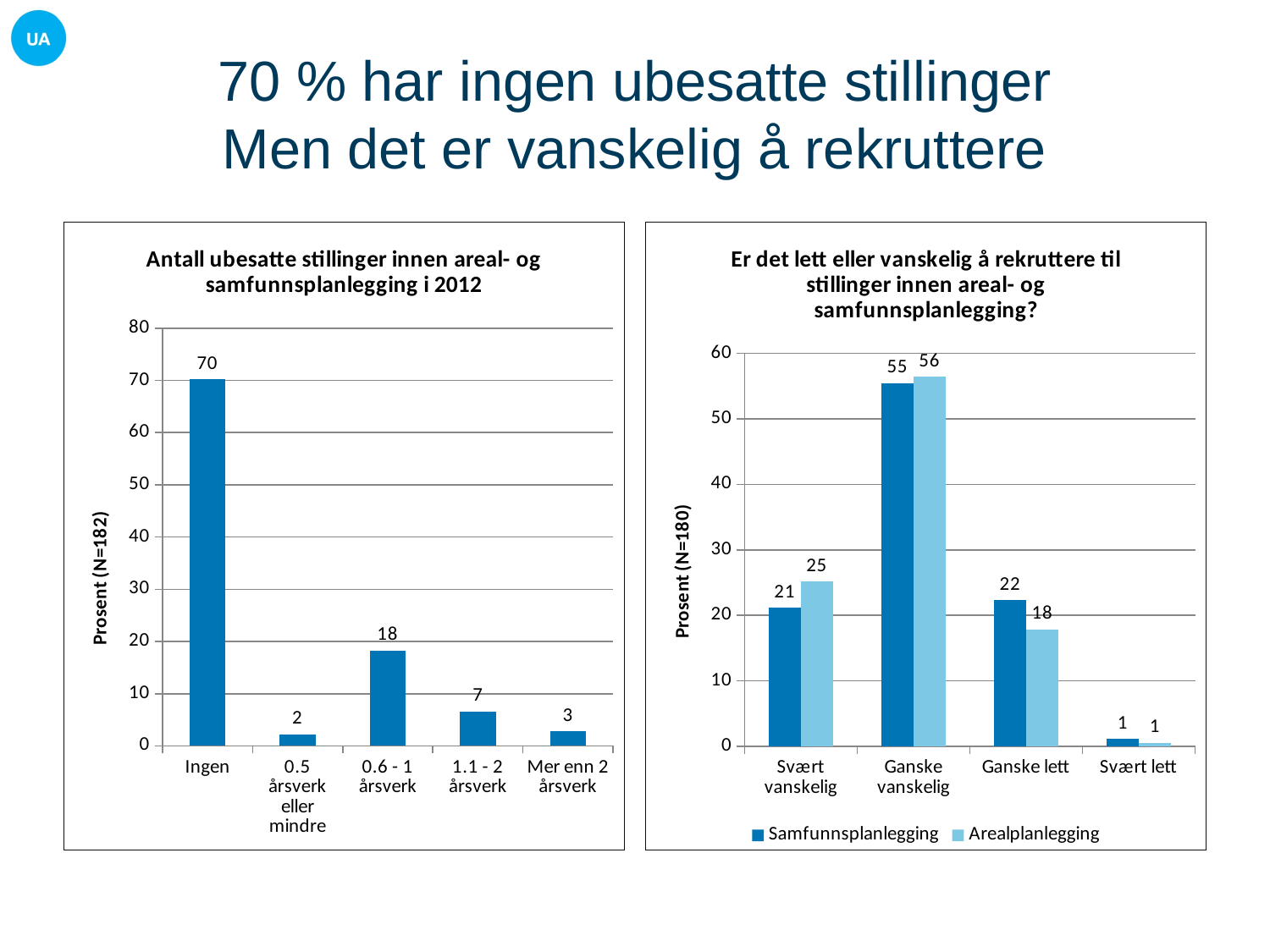
In the right chart (Er det lett eller vanskelig å rekruttere...), how many series does the legend list? 2 In the right chart (Er det lett eller vanskelig å rekruttere...), which category has the highest value for Samfunnsplanlegging? Ganske vanskelig In the right chart (Er det lett eller vanskelig å rekruttere...), what is the value for Arealplanlegging in the 'Svært vanskelig' category? 25 What kind of chart is the right chart (Er det lett eller vanskelig å rekruttere...)? Bar chart In the left chart (Antall ubesatte stillinger innen areal- og samfunnsplanlegging i 2012), what is the value for '0.6 - 1 årsverk'? 18 In the left chart (Antall ubesatte stillinger innen areal- og samfunnsplanlegging i 2012), which is larger: the value for '1.1 - 2 årsverk' or 'Mer enn 2 årsverk'? 1.1 - 2 årsverk In the right chart (Er det lett eller vanskelig å rekruttere...), what is the value for Samfunnsplanlegging in the 'Ganske lett' category? 22 In the right chart (Er det lett eller vanskelig å rekruttere...), what is the difference between Samfunnsplanlegging and Arealplanlegging in the 'Ganske lett' category? 4 In the left chart (Antall ubesatte stillinger innen areal- og samfunnsplanlegging i 2012), which category has the lowest value? 0.5 årsverk eller mindre In the left chart (Antall ubesatte stillinger innen areal- og samfunnsplanlegging i 2012), how many categories are shown on the x axis? 5 In the left chart (Antall ubesatte stillinger innen areal- og samfunnsplanlegging i 2012), what is the difference between the values for 'Ingen' and '0.6 - 1 årsverk'? 52 In the left chart (Antall ubesatte stillinger innen areal- og samfunnsplanlegging i 2012), what is the value for 'Ingen'? 70